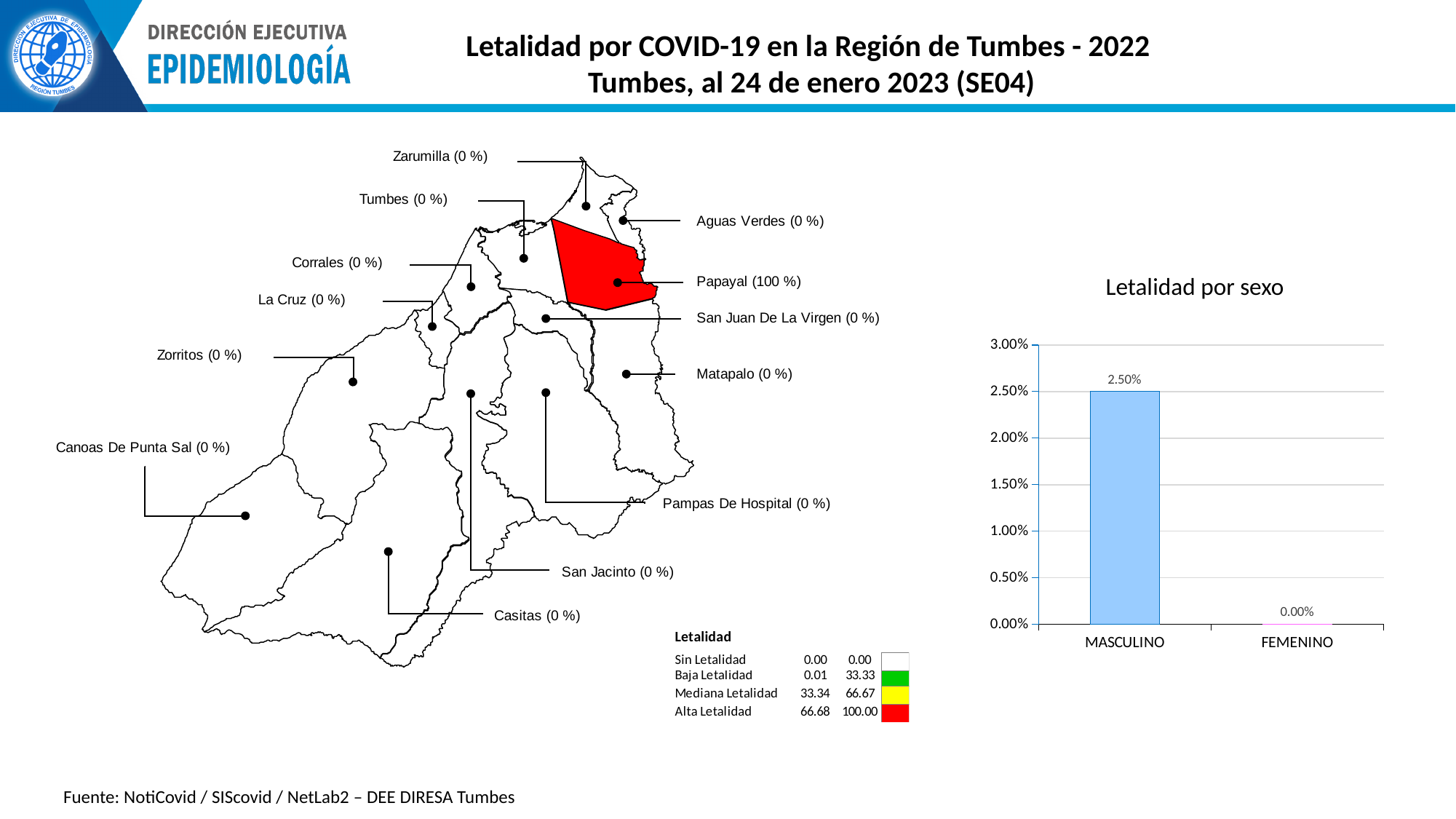
On the map on the left, which district is shaded red? Papayal What is the maximum value shown on the y axis of the 'Letalidad por sexo' chart? 3.00% In the 'Letalidad por sexo' chart, what is the value for MASCULINO? 2.50% In the 'Letalidad por sexo' chart, what is the value for FEMENINO? 0.00% What kind of chart is 'Letalidad por sexo'? Bar chart In the 'Letalidad por sexo' chart, what is the difference between the MASCULINO and FEMENINO values? 2.50% In the 'Letalidad por sexo' chart, which category has the highest value? MASCULINO In the 'Letalidad por sexo' chart, is the value for MASCULINO greater or less than 2.00%? greater In the 'Letalidad por sexo' chart, which category has the lowest value? FEMENINO On the map on the left, what is the lethality value shown for Papayal? 100 % How many categories are shown on the x axis of the 'Letalidad por sexo' chart? 2 In the 'Letalidad por sexo' chart, which is larger, the value for MASCULINO or for FEMENINO? MASCULINO